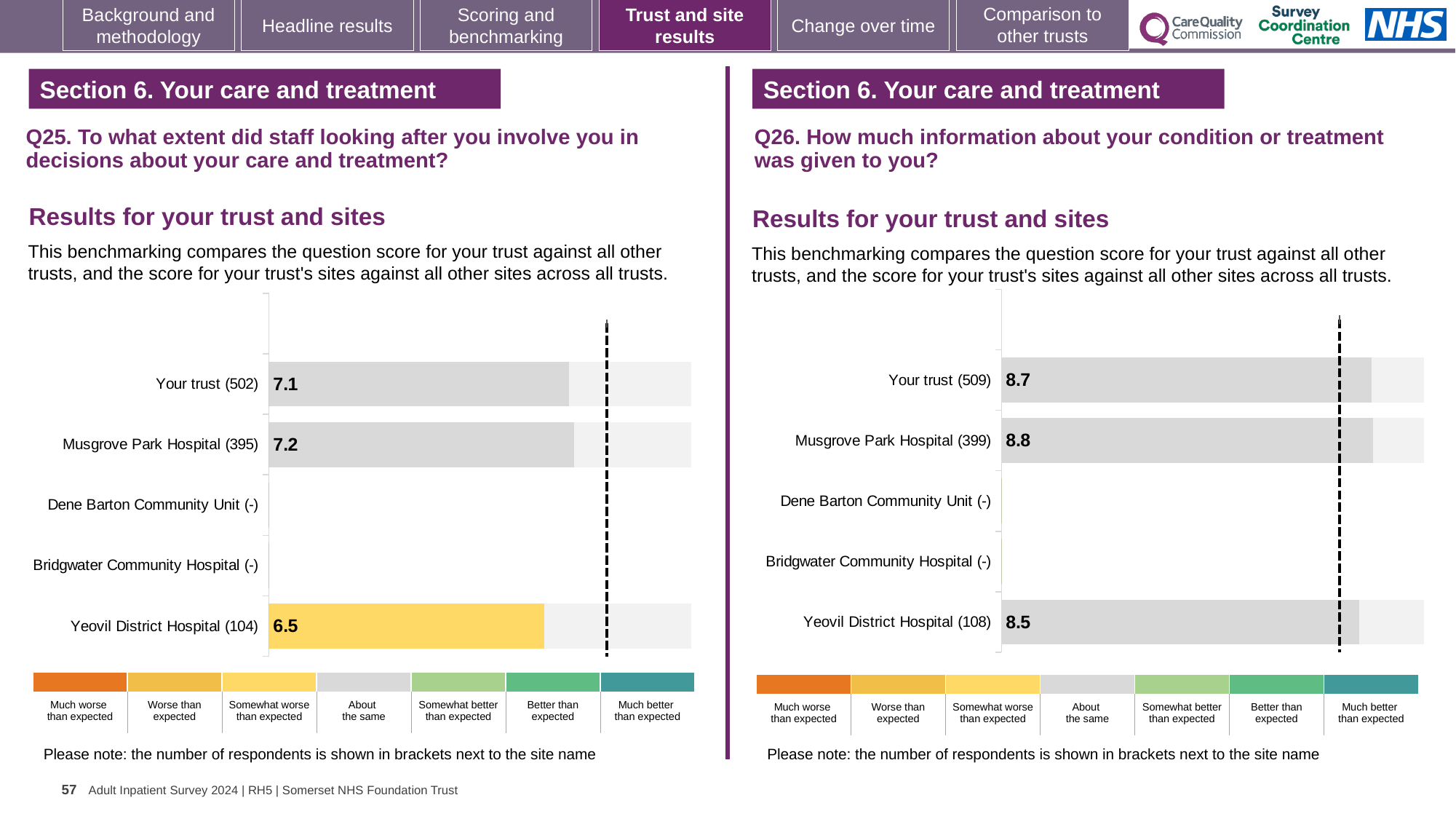
On the Q25 chart (left), what is the difference between the scores for Musgrove Park Hospital and Yeovil District Hospital? 0.7 On the Q25 chart (left), which site or trust has the lowest score? Yeovil District Hospital (104) On the Q26 chart (right), what is the score for Musgrove Park Hospital (399)? 8.8 On the Q25 chart (left), what is the score for Your trust (502)? 7.1 On the Q26 chart (right), what is the difference between the scores for Your trust and Yeovil District Hospital? 0.2 On the Q25 chart (left), how many rows (trust and sites) are listed? 5 On the Q25 chart (left), what is the score for Yeovil District Hospital (104)? 6.5 On the Q25 chart (left), which has the larger score, Your trust or Yeovil District Hospital? Your trust On the Q26 chart (right), which site or trust has the highest score? Musgrove Park Hospital (399) On the Q25 chart (left), which benchmark category does the colour of the Yeovil District Hospital bar correspond to? Somewhat worse than expected On the Q26 chart (right), what is the score for Yeovil District Hospital (108)? 8.5 What kind of chart is used on the Q26 chart (right)? Bar chart